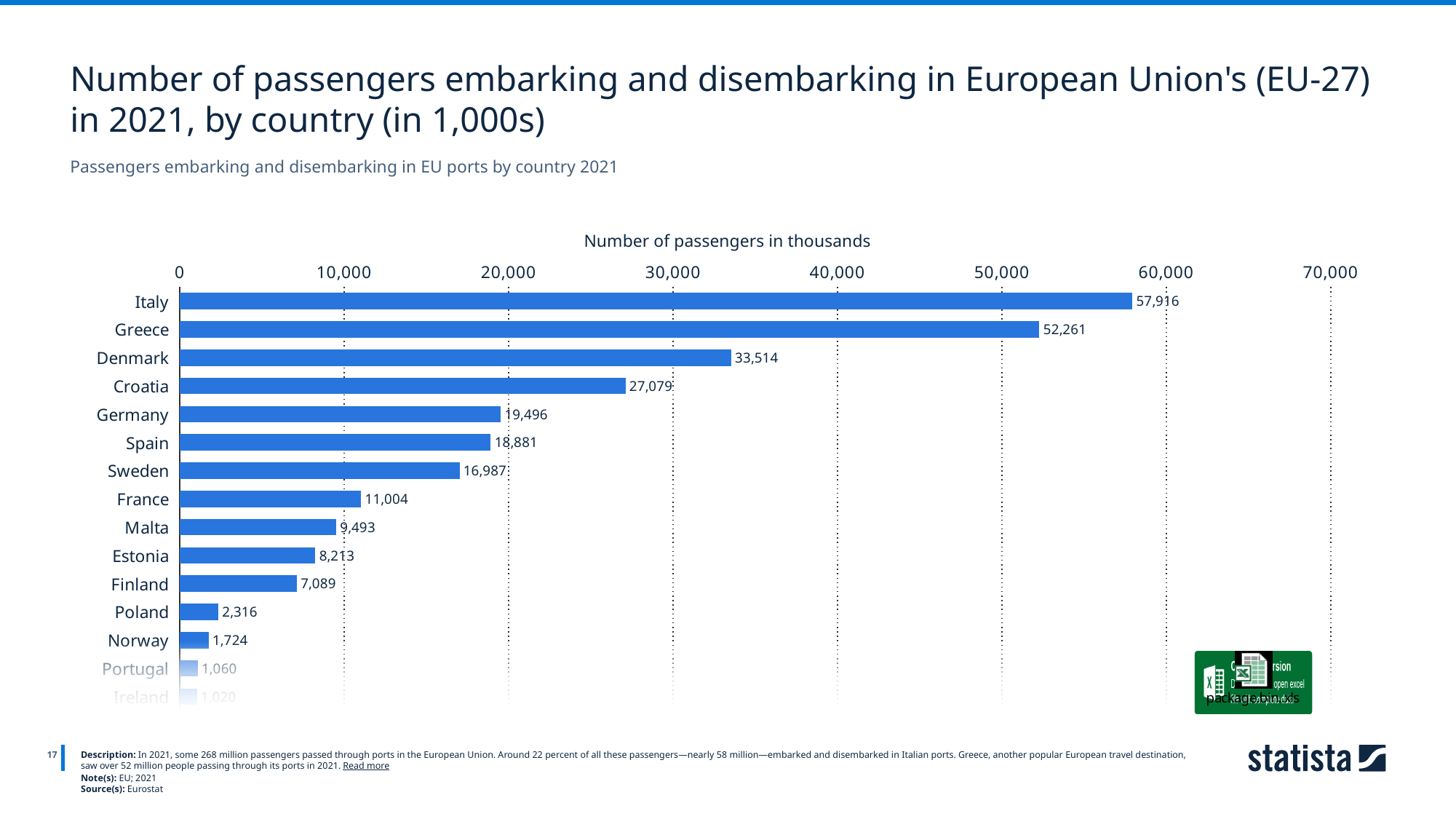
What is the number of passengers for Denmark? 33,514 What is the label of the horizontal axis? Number of passengers in thousands Is the value for Greece greater or less than 50,000? greater What is the number of passengers for Sweden? 16,987 What is the difference between the values for Italy and Greece? 5,655 Which country has the highest number of passengers? Italy What kind of chart is shown on the slide? Bar chart What is the number of passengers for Italy? 57,916 What is the number of passengers for Finland? 7,089 Which has a larger value, Croatia or Denmark? Denmark Which has a larger value, Malta or France? France What is the difference between the values for Germany and Spain? 615